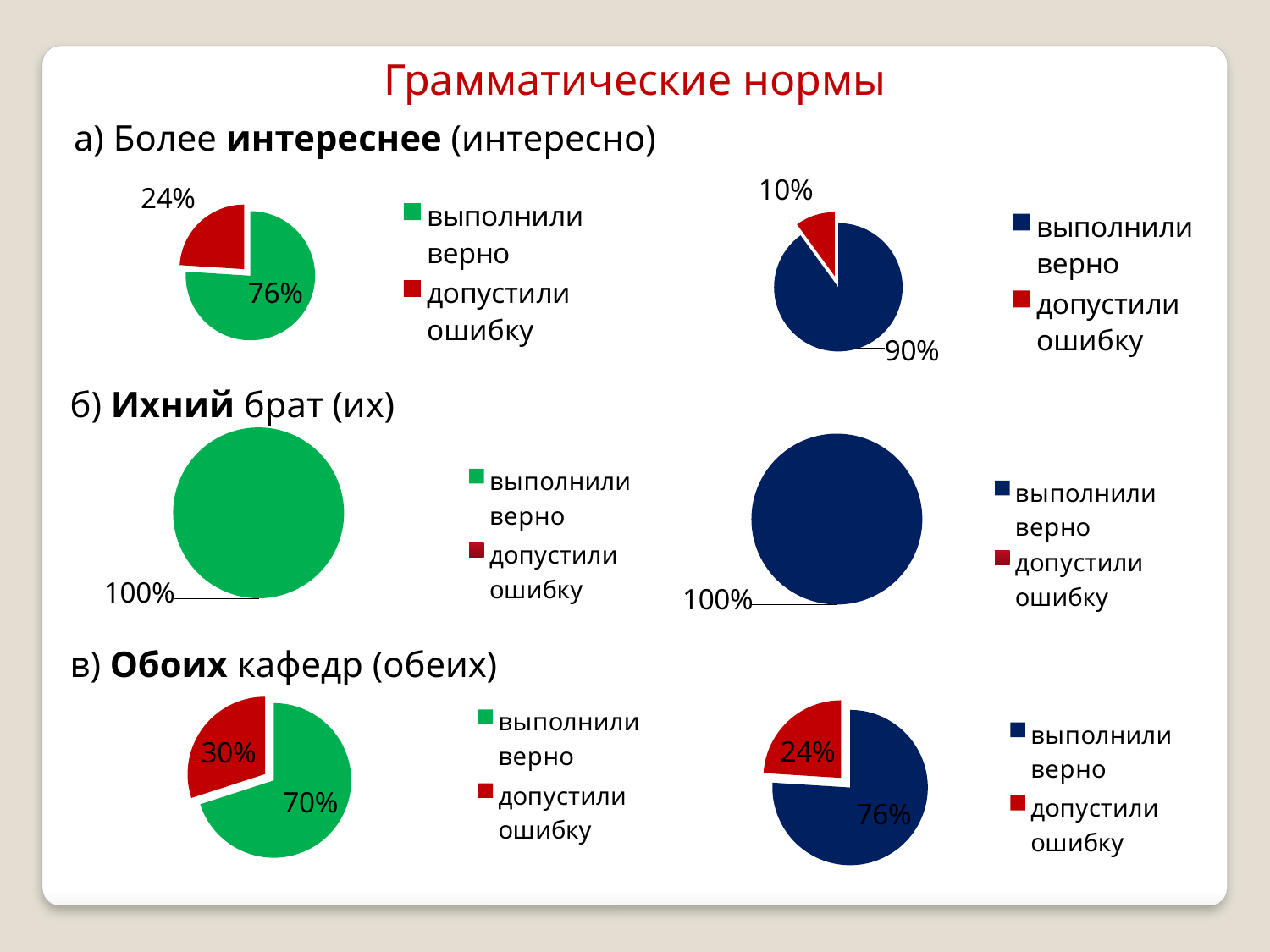
In the left pie chart of row в) «Обоих кафедр», what share is labelled «допустили ошибку»? 30% In the left pie chart of row б) «Ихний брат», what share is labelled «выполнили верно»? 100% How many entries does the legend of the left pie chart in row в) «Обоих кафедр» list? 2 In the right pie chart of row а) «Более интереснее», which slice is larger: «выполнили верно» or «допустили ошибку»? выполнили верно In the left pie chart of row в) «Обоих кафедр», what is the difference between the «выполнили верно» and «допустили ошибку» shares? 40% In the right pie chart of row а) «Более интереснее», what share is labelled «допустили ошибку»? 10% In the right pie chart of row а) «Более интереснее», what share is labelled «выполнили верно»? 90% How many pie charts are shown on the slide? 6 What type of chart is used throughout the slide? pie chart In the right pie chart of row в) «Обоих кафедр», what share is labelled «выполнили верно»? 76% In the left pie chart of row а) «Более интереснее», what share is labelled «выполнили верно»? 76% In the left pie chart of row а) «Более интереснее», what share is labelled «допустили ошибку»? 24%